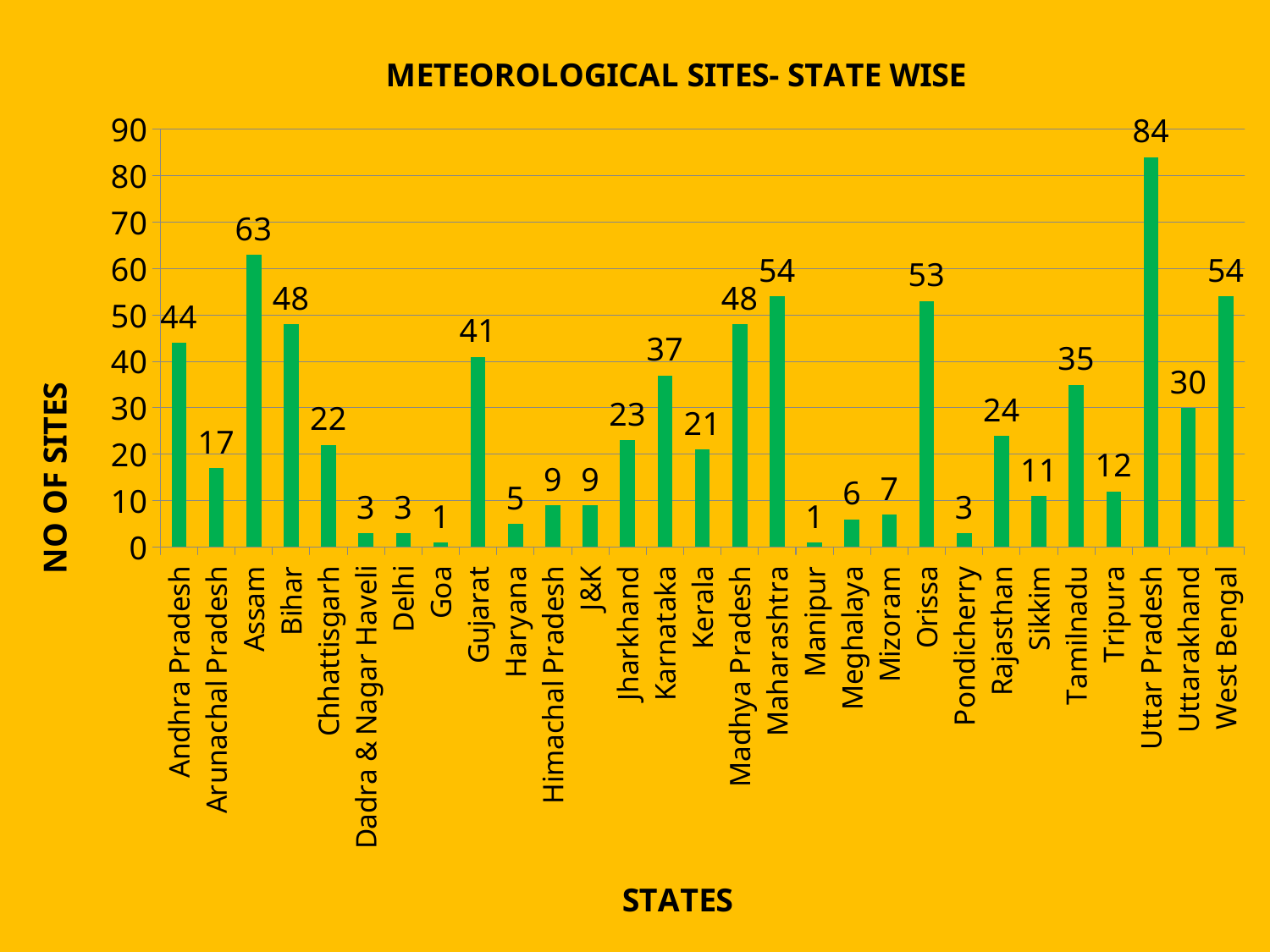
What is the label of the vertical axis? NO OF SITES What type of chart is shown on the slide? Bar chart How many sites are shown for Tamilnadu? 35 What is the title of the chart? METEOROLOGICAL SITES- STATE WISE Which state has the highest number of meteorological sites? Uttar Pradesh What is the number of sites for Gujarat? 41 Which has more sites, Karnataka or Kerala? Karnataka What is the difference in number of sites between Uttar Pradesh and West Bengal? 30 How many states are shown on the x axis of the chart? 29 How many meteorological sites does Uttar Pradesh have? 84 What is the difference in number of sites between Assam and Bihar? 15 Which has more sites, Orissa or Maharashtra? Maharashtra